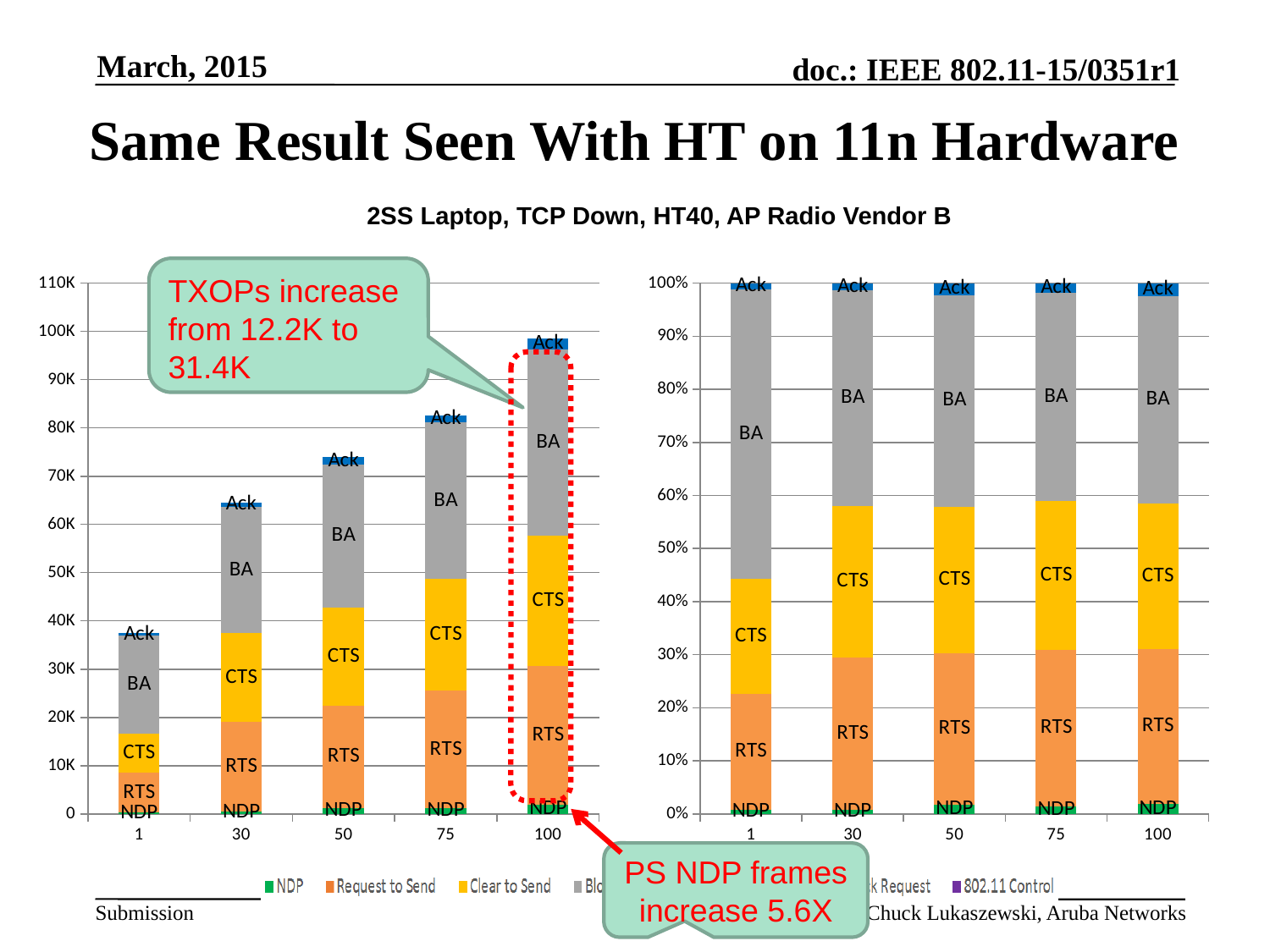
What is the subtitle printed above the two charts? 2SS Laptop, TCP Down, HT40, AP Radio Vendor B In the left chart, is the total height of the bar for category 50 greater or less than 70K? greater In the left chart, which category has the tallest stacked bar? 100 In the left chart, which category has the shortest stacked bar? 1 In the left chart, is the total height of the bar for category 100 greater or less than 90K? greater What kind of chart is the left chart on the slide? Stacked bar chart In the left chart, is the total height of the bar for category 1 greater or less than 40K? less In the left chart, do the total bar heights rise or fall as the x-axis values go from 1 to 100? Rise According to the callout on the left chart, TXOPs increase from what value to what value? From 12.2K to 31.4K In the right chart, is the BA segment a larger share of the bar for category 1 or for category 30? 1 How many categories are shown on the x axis of the left chart? 5